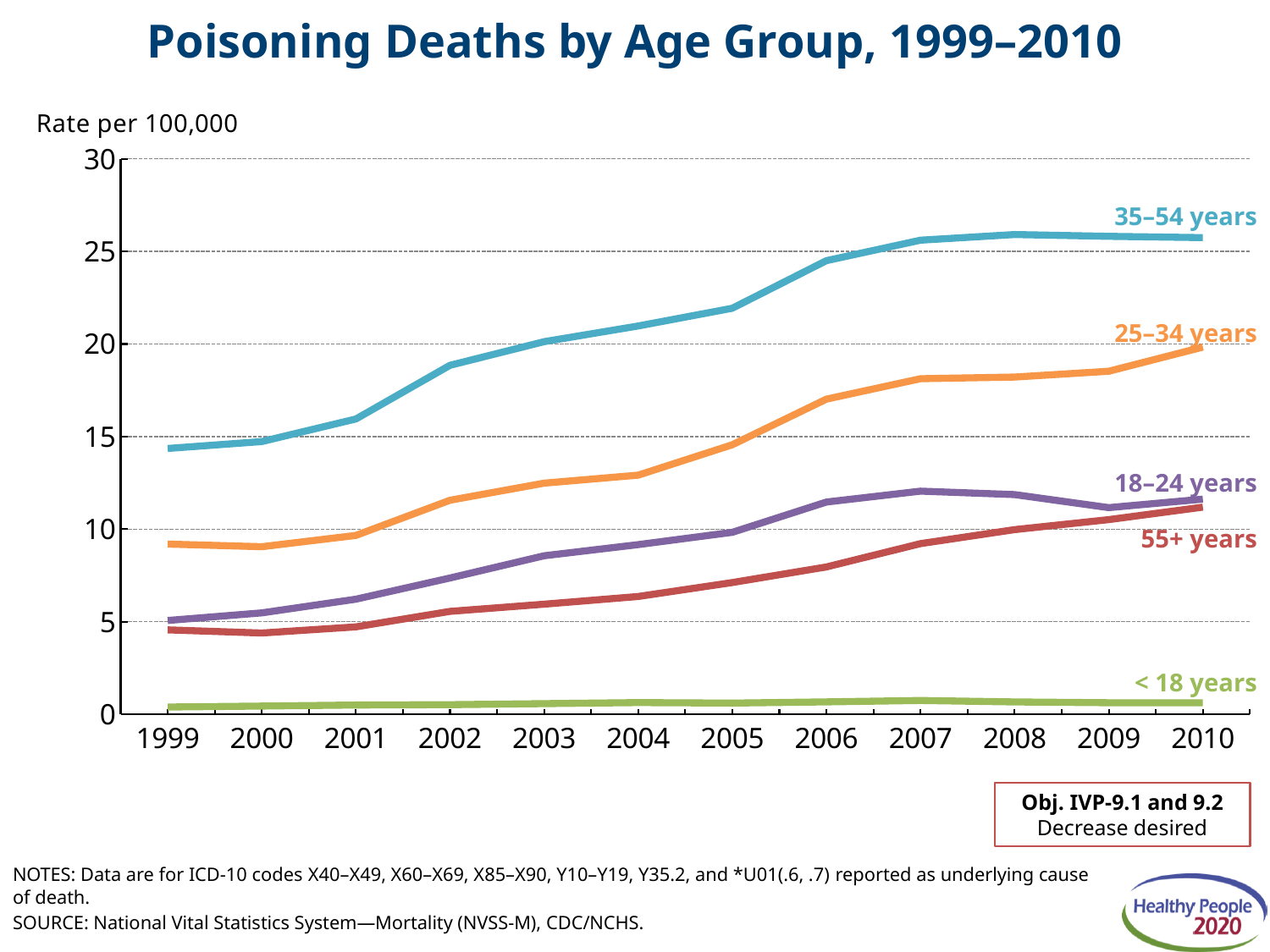
How many age-group series are plotted on the chart? 5 Is the value for the 35–54 years group in 2010 greater or less than 25? greater What is the title of the chart? Poisoning Deaths by Age Group, 1999–2010 Which age group has the lowest poisoning death rate throughout 1999–2010? < 18 years In 2005, which group has the larger rate: 25–34 years or 18–24 years? 25–34 years Is the value for the 55+ years group in 1999 greater or less than 5? less How many years are shown along the x axis? 12 Does the rate for the 35–54 years group rise or fall from 1999 to 2010? Rise Which age group has the highest poisoning death rate in 2010? 35–54 years Is the value for the 25–34 years group in 1999 greater or less than 10? less What unit is the y axis measured in, according to the axis label? Rate per 100,000 What kind of chart is shown on the slide? Line chart